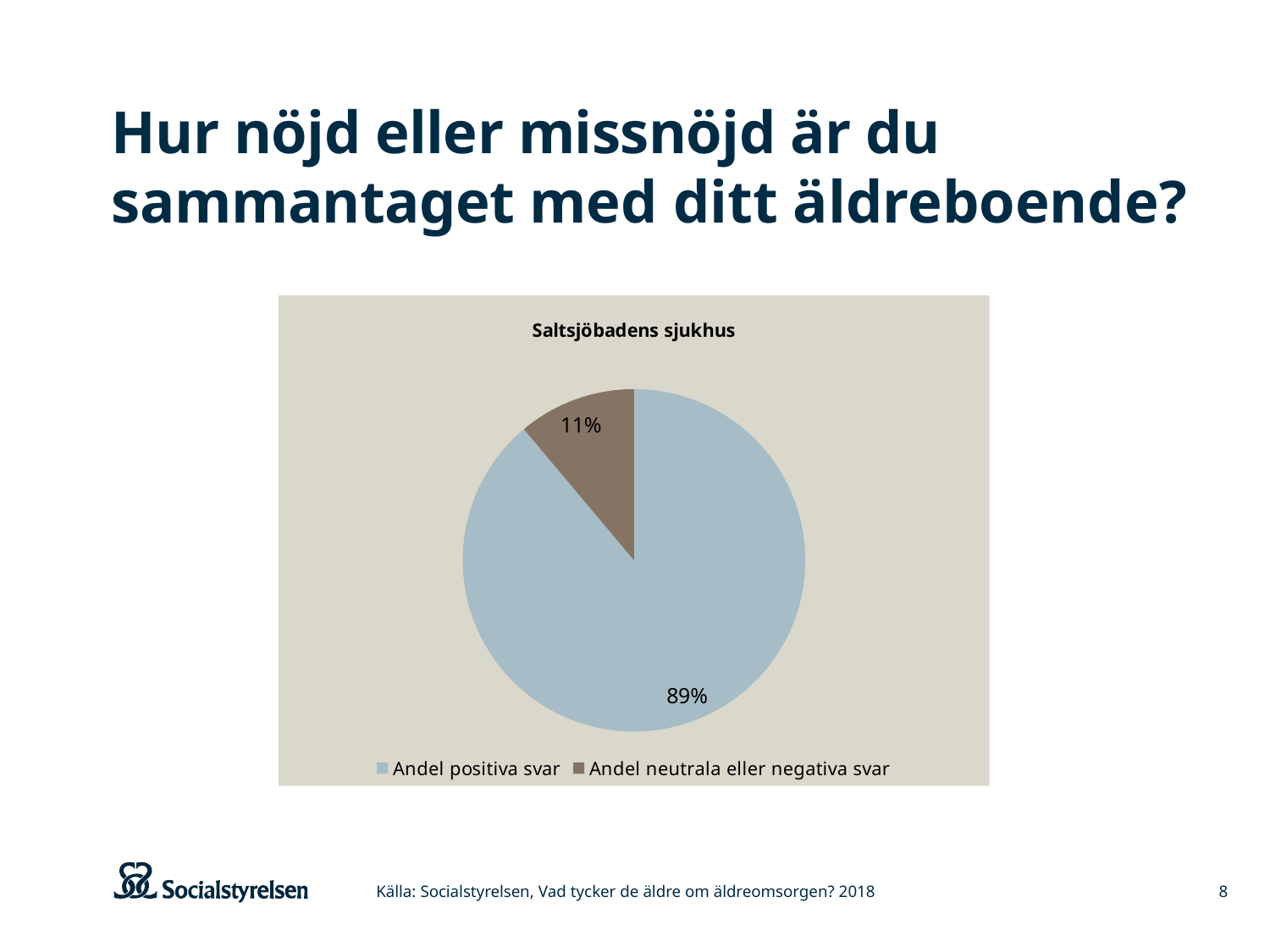
What colour is the 'Andel neutrala eller negativa svar' slice? brown What kind of chart is shown on the slide? pie chart How many entries does the legend list? 2 What is the title of the chart? Saltsjöbadens sjukhus What share of the pie is 'Andel neutrala eller negativa svar'? 11% What share of the pie is 'Andel positiva svar'? 89% How many slices does the pie chart have? 2 Which slice is the smallest? Andel neutrala eller negativa svar What is the difference between the 'Andel positiva svar' share and the 'Andel neutrala eller negativa svar' share? 78% Which is larger: 'Andel positiva svar' or 'Andel neutrala eller negativa svar'? Andel positiva svar Which slice is the largest? Andel positiva svar